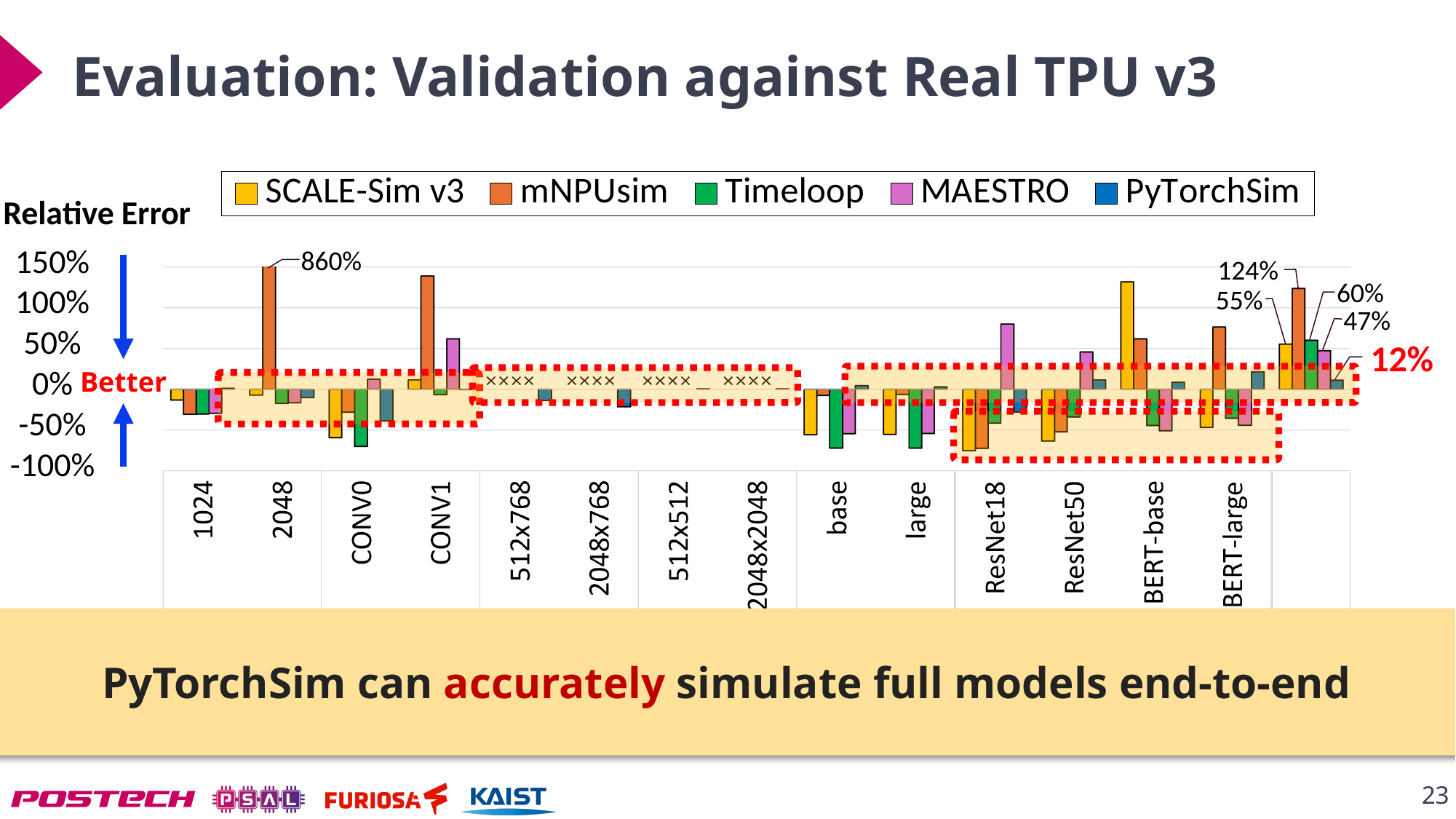
Is the value for mNPUsim at CONV1 greater or less than 100%? greater Is the value for SCALE-Sim v3 at BERT-base greater or less than 100%? greater How many series does the legend list? 5 Which series has the highest relative error for the 2048 category? mNPUsim What is the labelled relative error of mNPUsim for the 2048 category? 860% Which series are listed in the legend? SCALE-Sim v3, mNPUsim, Timeloop, MAESTRO, PyTorchSim What quantity does the vertical axis of the chart represent? Relative Error What kind of chart is shown on the slide? bar chart Is the value for MAESTRO at ResNet18 greater or less than 50%? greater For the 2048 category, which is larger: the mNPUsim value or the SCALE-Sim v3 value? mNPUsim